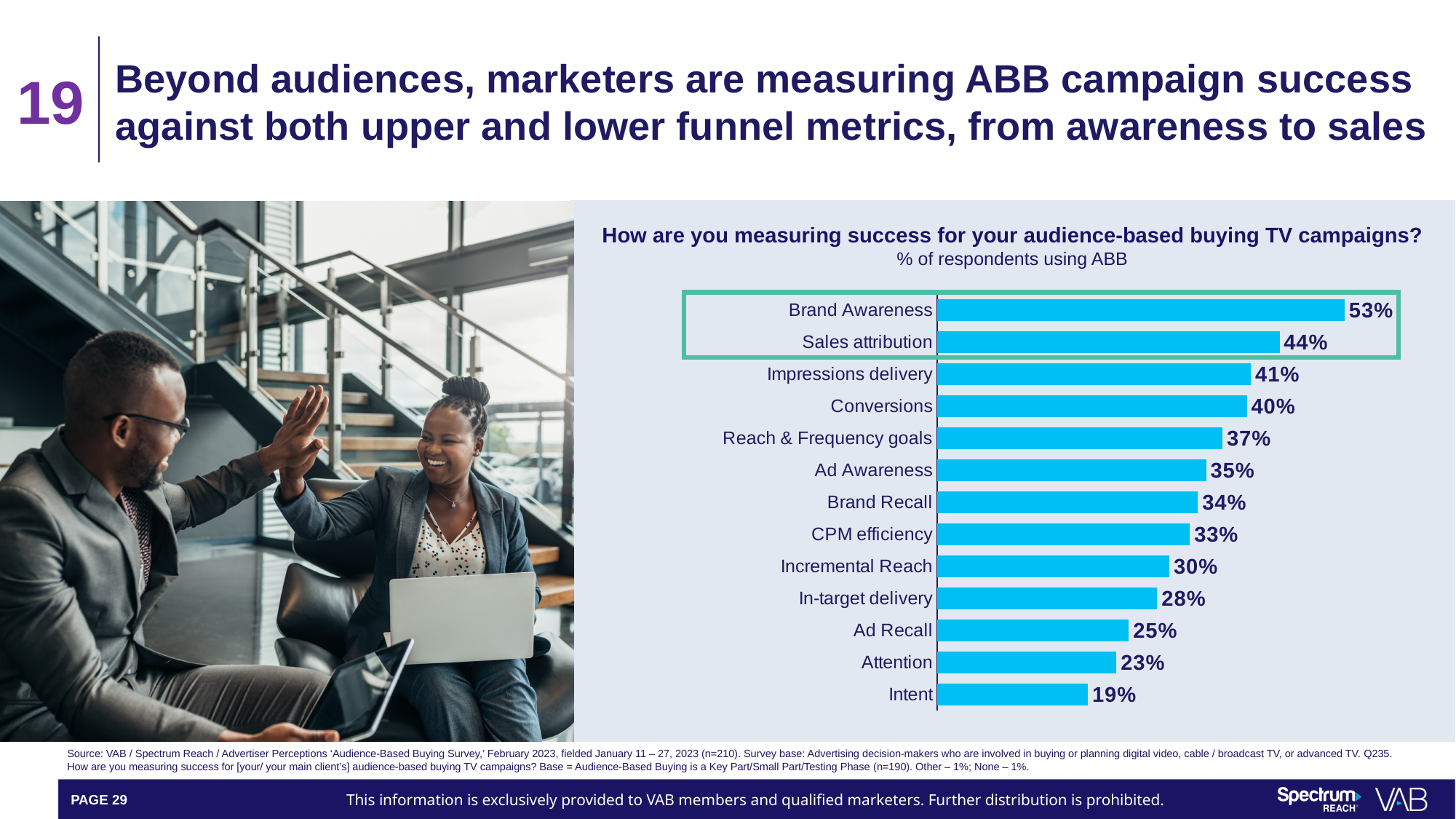
What type of chart is used on this slide? Bar chart What is the value for Intent? 19% What is the difference in percentage points between Brand Awareness and Sales attribution? 9 How many metrics are shown in the chart? 13 Which metric has the highest percentage of respondents? Brand Awareness What is the value shown for Sales attribution? 44% What percentage of respondents measure success by Brand Awareness? 53% What percentage of respondents use CPM efficiency to measure success? 33% Which metric has the lowest percentage of respondents? Intent Which has a higher value, Impressions delivery or Reach & Frequency goals? Impressions delivery What is the difference in percentage points between Conversions and Attention? 17 Which two metrics are highlighted with a green box in the chart? Brand Awareness and Sales attribution